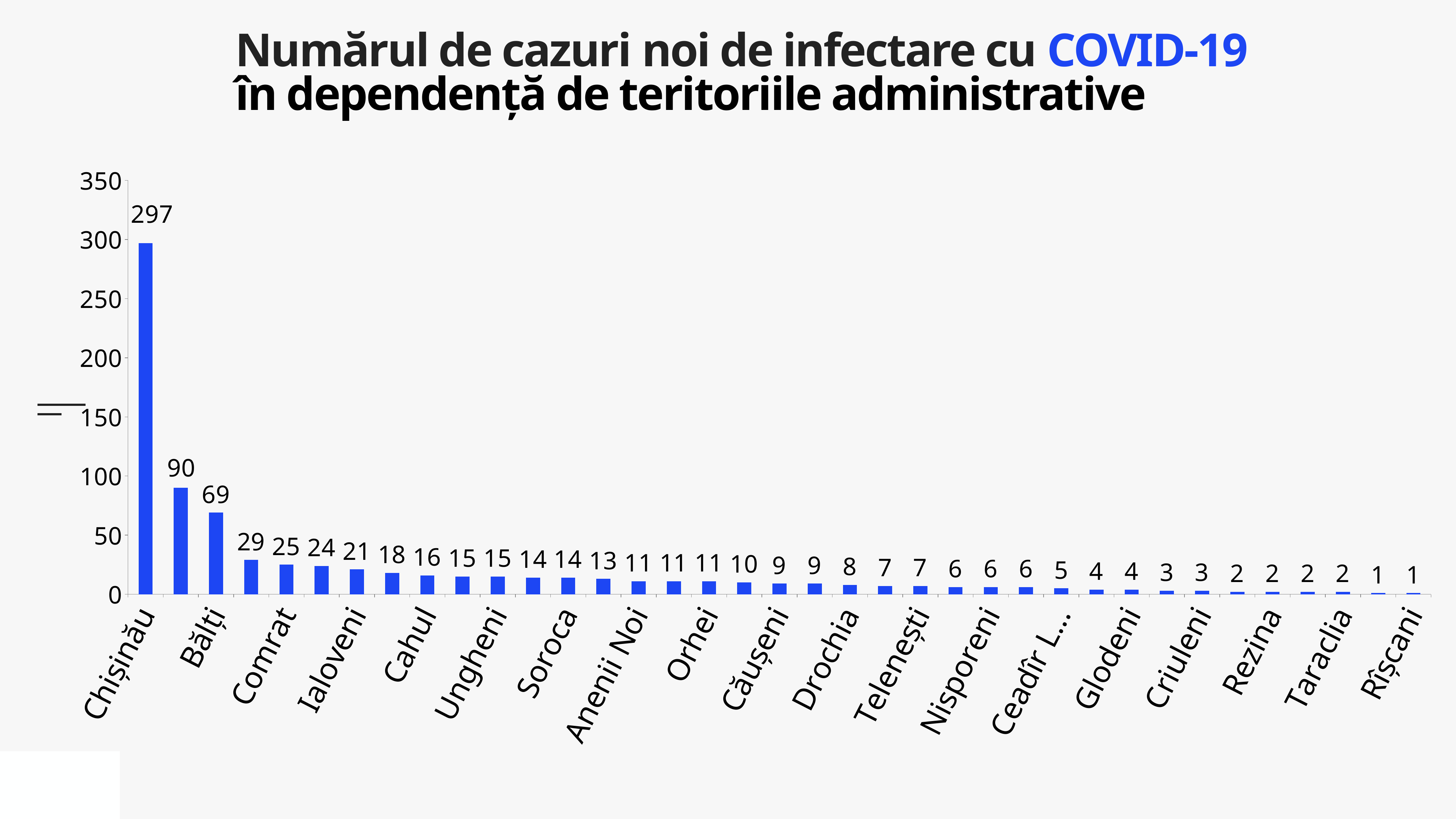
Which has more new cases, Chișinău or Bălți? Chișinău What is the highest tick value shown on the vertical axis? 350 How many new cases are shown for Rîșcani? 1 What kind of chart is shown on the slide? bar chart Is the value for Chișinău greater or less than 250? greater How many new COVID-19 cases are shown for Chișinău? 297 Which administrative territory has the highest number of new COVID-19 cases? Chișinău What is the value of the second-highest bar in the chart? 90 What is the difference between the values for Chișinău and Rîșcani? 296 What colour are the bars in the chart? blue Do the values rise or fall moving from left to right along the x axis? fall Which territory has the lowest number of new cases, shown by the last bar on the right? Rîșcani